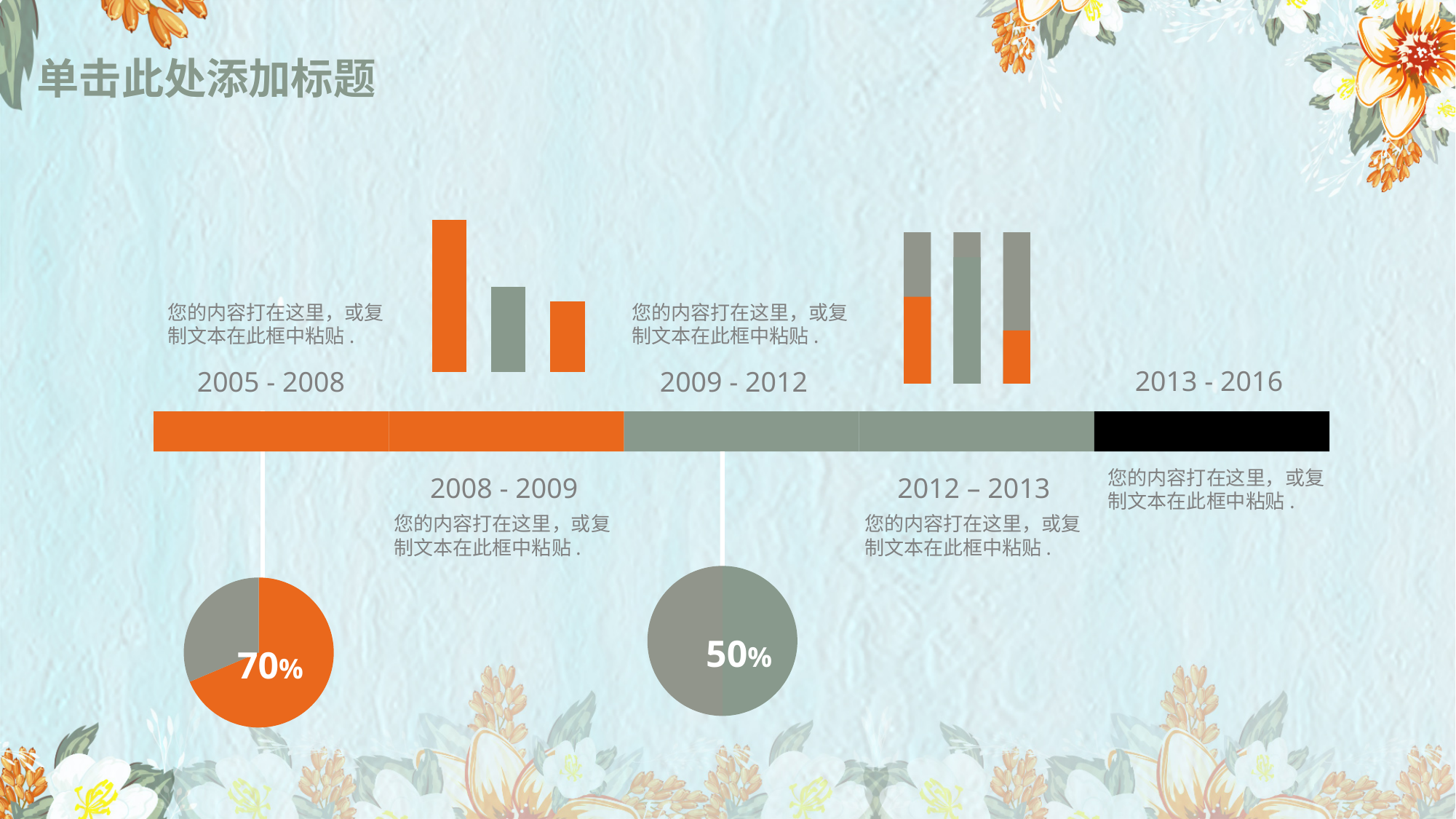
How many slices does the lower-left pie chart with the 70% label have? 2 In the bar chart above the 2005 - 2008 label, do the bars rise or fall from left to right? fall In the lower-left pie chart, what colour is the slice labelled 70%? orange What is the difference between the percentages printed on the two pie charts? 20% What kind of chart is shown above the 2005 - 2008 label on the timeline? bar chart What percentage is printed on the pie chart at the lower centre of the slide? 50% In the bar chart above the 2005 - 2008 label, what colour is the tallest bar? orange How many bars are in the bar chart above the 2005 - 2008 label? 3 What kind of chart is shown at the lower left of the slide with the 70% label? pie chart How many bars are in the stacked bar chart above the 2012 – 2013 label? 3 What percentage is printed on the pie chart at the lower left of the slide? 70% Which pie chart shows the larger printed percentage, the lower-left one or the lower-centre one? the lower-left one (70%)